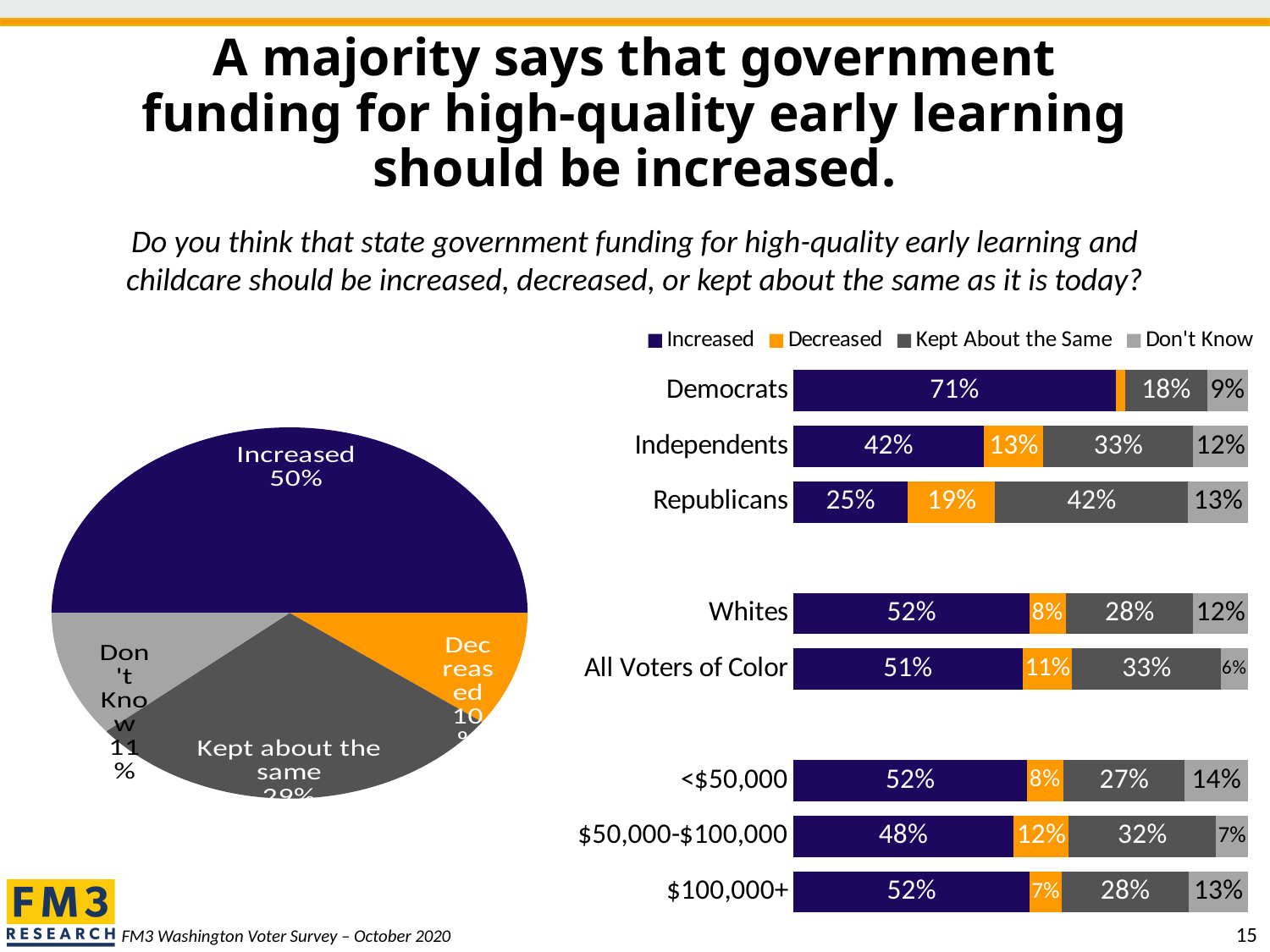
In the bar chart on the right, which group has the highest percentage saying funding should be increased? Democrats How many groups are shown in the bar chart on the right? 8 In the bar chart on the right, which group has a higher Decreased percentage, Republicans or Independents? Republicans In the pie chart on the left, what share of respondents said funding should be increased? 50% In the bar chart on the right, what percentage of Independents said funding should be decreased? 13% How many series does the legend of the bar chart on the right list? 4 In the bar chart on the right, which group has the lowest percentage saying funding should be increased? Republicans In the pie chart on the left, what percentage of respondents answered Don't Know? 11% What kind of chart is shown on the left side of the slide? Pie chart In the bar chart on the right, what is the difference in percentage points between Democrats and Republicans saying funding should be increased? 46 percentage points In the bar chart on the right, what percentage of Republicans said funding should be kept about the same? 42% In the bar chart on the right, what percentage of Democrats said funding should be increased? 71%